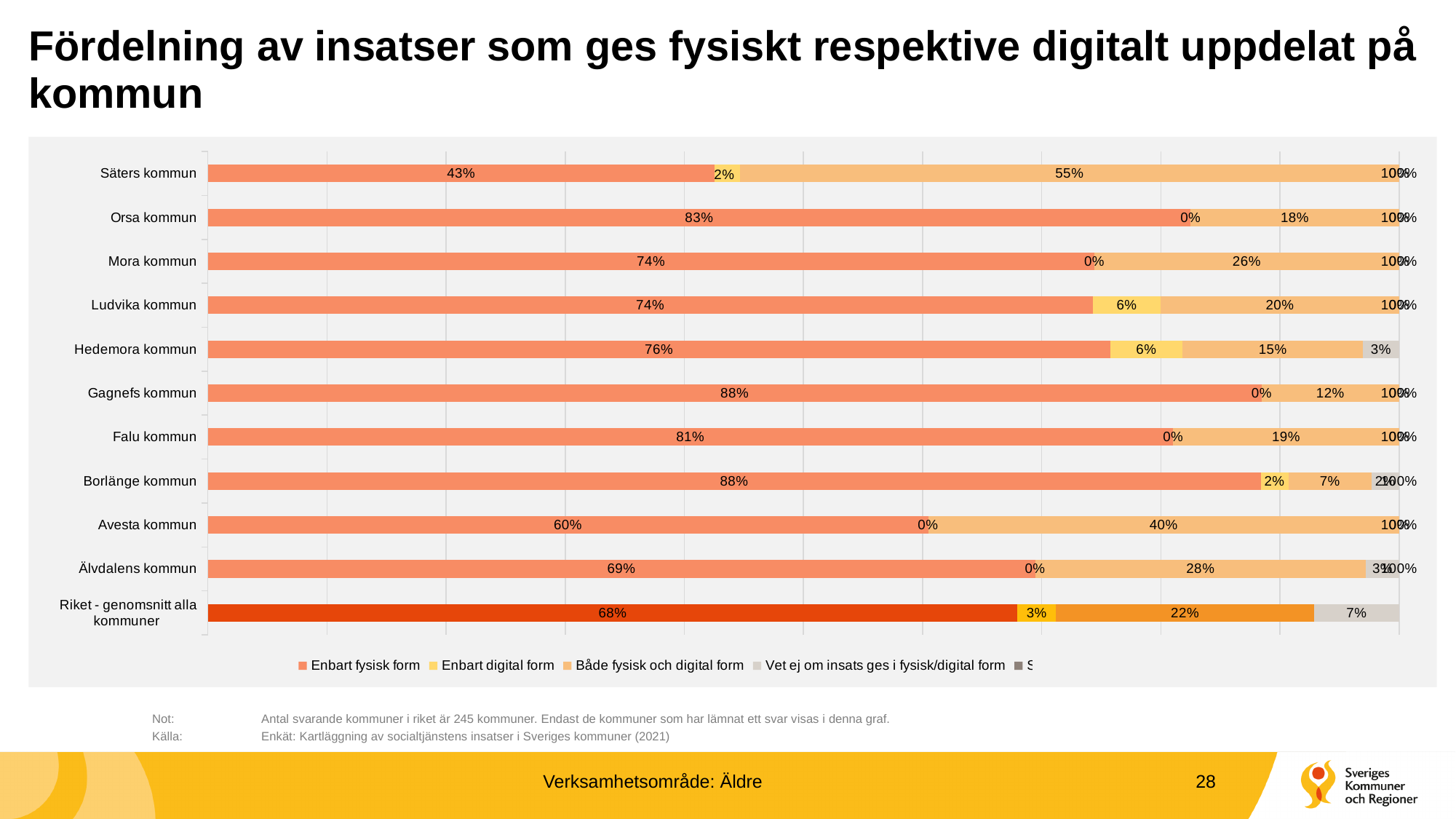
What is the difference between the Enbart fysisk form values for Orsa kommun and Mora kommun? 9 percentage points What is the value for Vet ej om insats ges i fysisk/digital form for Riket - genomsnitt alla kommuner? 7% What is the value for Både fysisk och digital form for Avesta kommun? 40% What is the value for Enbart fysisk form for Säters kommun? 43% What kind of chart is shown on the slide? Stacked bar chart Which category has the highest value for Både fysisk och digital form? Säters kommun What is the value for Vet ej om insats ges i fysisk/digital form for Hedemora kommun? 3% What is the value for Enbart digital form for Riket - genomsnitt alla kommuner? 3% Which has a larger Enbart fysisk form value, Ludvika kommun or Hedemora kommun? Hedemora kommun How many categories (rows) are shown on the chart? 11 What is the title of the slide? Fördelning av insatser som ges fysiskt respektive digitalt uppdelat på kommun Which category has the lowest value for Enbart fysisk form? Säters kommun